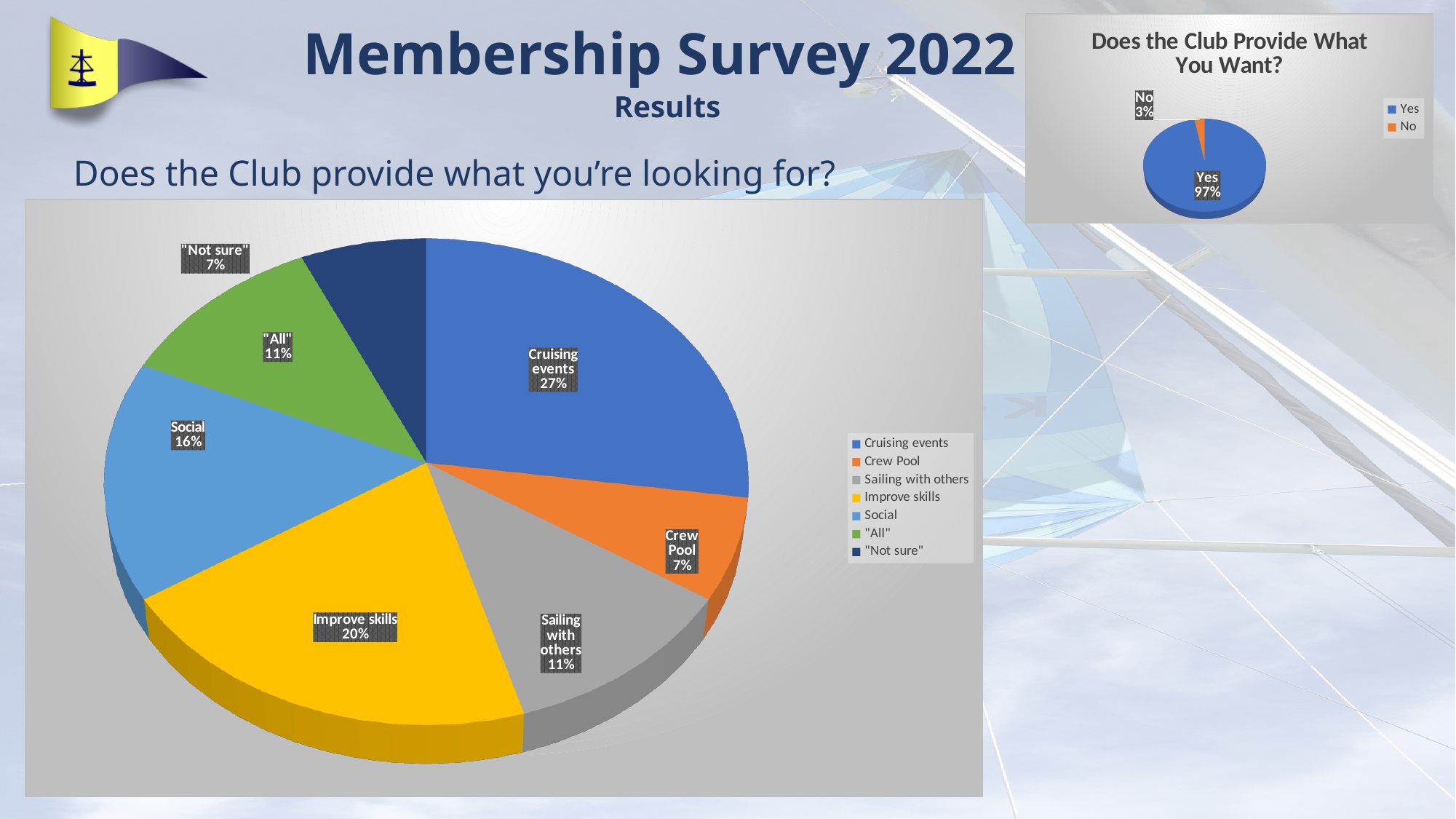
In the large pie chart on the left, what share does Cruising events have? 27% In the large pie chart on the left, what share does Improve skills have? 20% In the chart titled 'Does the Club Provide What You Want?', what share answered Yes? 97% In the large pie chart on the left, which category has the largest share? Cruising events In the large pie chart on the left, what colour is the Improve skills slice? Yellow In the large pie chart on the left, what is the difference between the shares for Cruising events and Improve skills? 7% In the large pie chart on the left, what share does Social have? 16% In the large pie chart on the left, how many categories does the legend list? 7 In the large pie chart on the left, which is larger: the share for Social or the share for Sailing with others? Social What kind of chart is the large chart on the left? Pie chart In the chart titled 'Does the Club Provide What You Want?', how many series does the legend list? 2 In the chart titled 'Does the Club Provide What You Want?', what share answered No? 3%